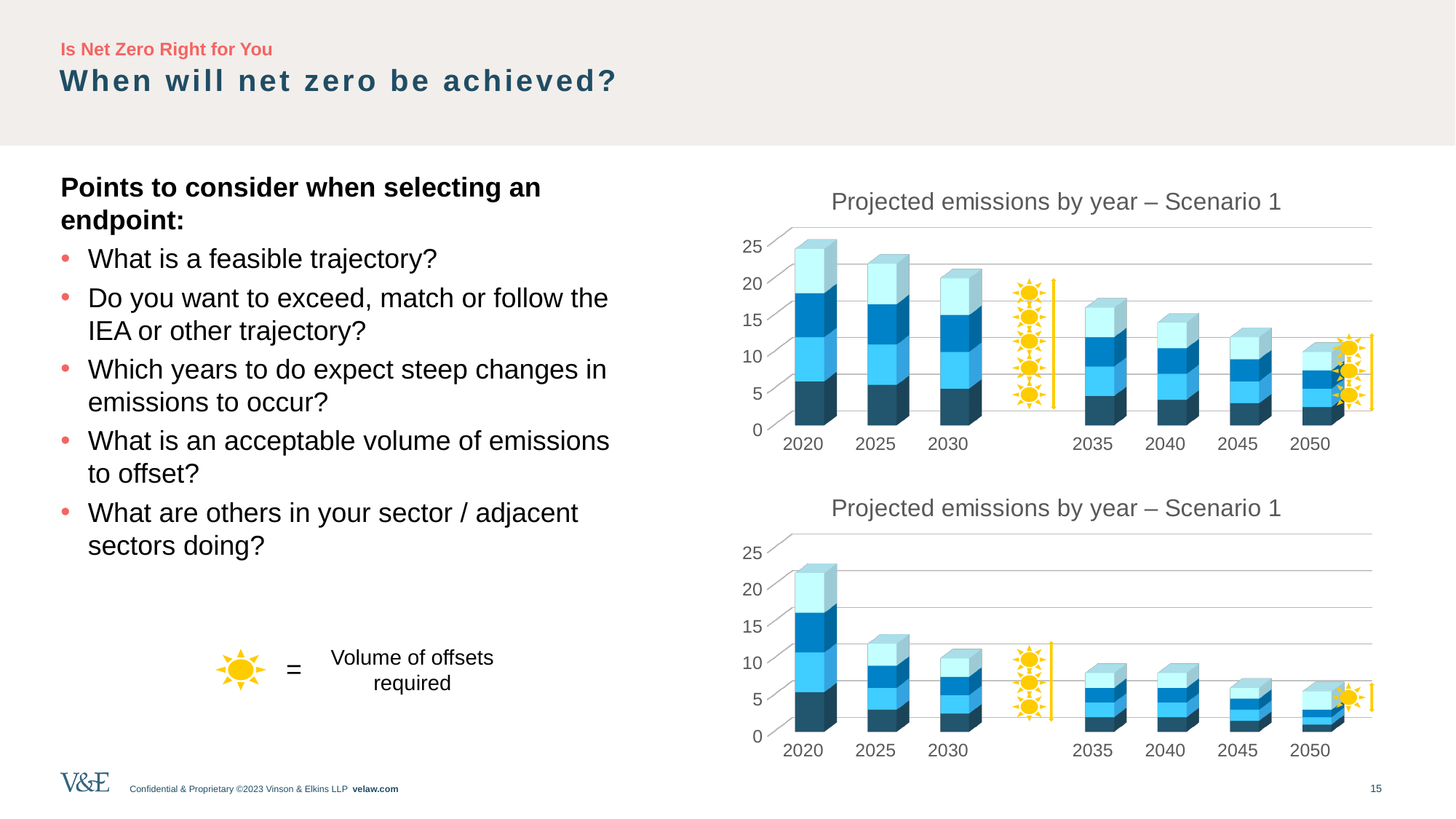
In the top chart, how many years are shown on the x axis? 7 In the bottom chart, is the total value for 2050 greater or less than 10? less In the top chart, which year has the lowest total projected emissions? 2050 What type of chart is the top chart on the slide? bar chart In the top chart, is the total value for 2050 greater or less than 15? less In the top chart, which year has the highest total projected emissions? 2020 In the bottom chart, is the total value for 2020 greater or less than 15? greater In the bottom chart, which is larger, the total for 2020 or the total for 2025? 2020 What is the title of the bottom chart? Projected emissions by year – Scenario 1 In the top chart, do the total projected emissions rise or fall from 2020 to 2050? fall In the bottom chart, which year has the highest total projected emissions? 2020